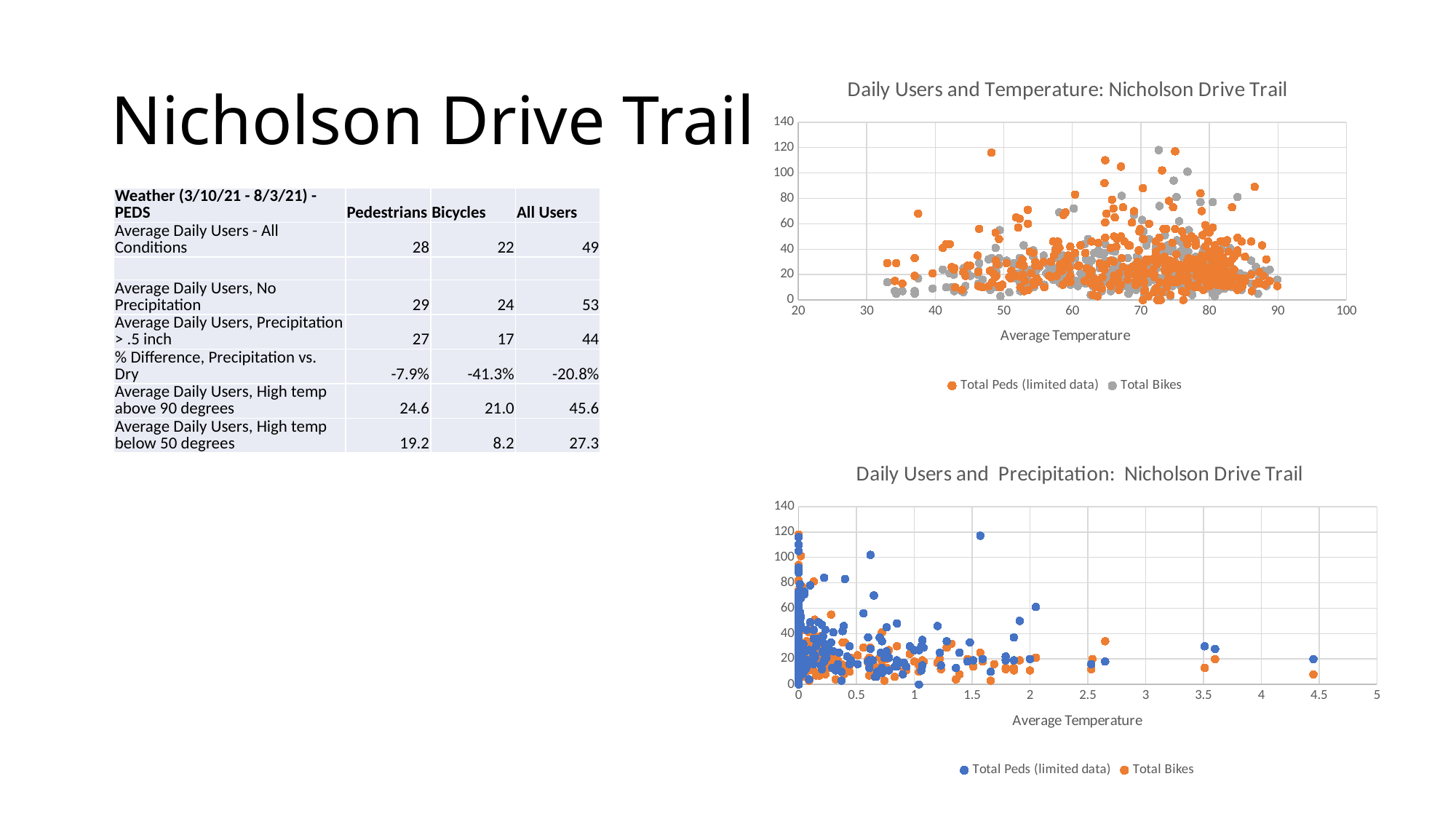
What kind of chart is the top chart, 'Daily Users and Temperature: Nicholson Drive Trail'? scatter chart What kind of chart is the bottom chart, 'Daily Users and Precipitation: Nicholson Drive Trail'? scatter chart What is the x-axis title of the bottom chart, 'Daily Users and Precipitation: Nicholson Drive Trail'? Average Temperature In the bottom chart, 'Daily Users and Precipitation: Nicholson Drive Trail', is the highest plotted value greater or less than 100? greater How many series does the legend of the bottom chart, 'Daily Users and Precipitation: Nicholson Drive Trail', list? 2 How many series does the legend of the top chart, 'Daily Users and Temperature: Nicholson Drive Trail', list? 2 In the top chart, 'Daily Users and Temperature: Nicholson Drive Trail', is the highest plotted value greater or less than 100? greater What are the two series named in the legend of the top chart, 'Daily Users and Temperature: Nicholson Drive Trail'? Total Peds (limited data) and Total Bikes